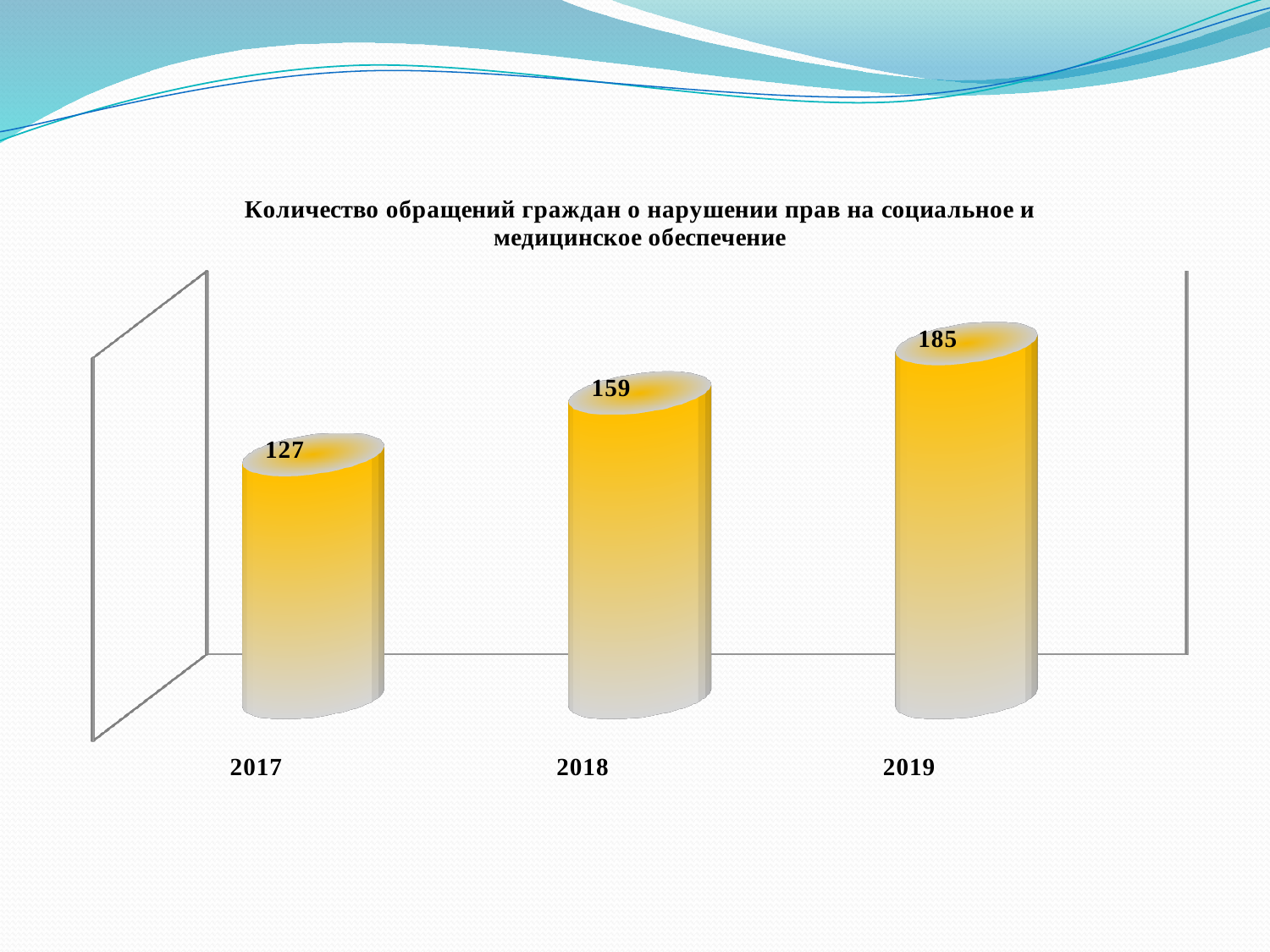
What kind of chart is this? bar chart What is the value for 2019? 185 Do the values rise or fall from 2017 to 2019? rise Which is larger, the value for 2018 or the value for 2019? 2019 What is the title of the chart? Количество обращений граждан о нарушении прав на социальное и медицинское обеспечение What is the value for 2017? 127 What is the difference between the values for 2018 and 2017? 32 What is the value for 2018? 159 How many years are shown on the chart? 3 Which year has the highest value? 2019 Which year has the lowest value? 2017 What is the difference between the values for 2019 and 2017? 58